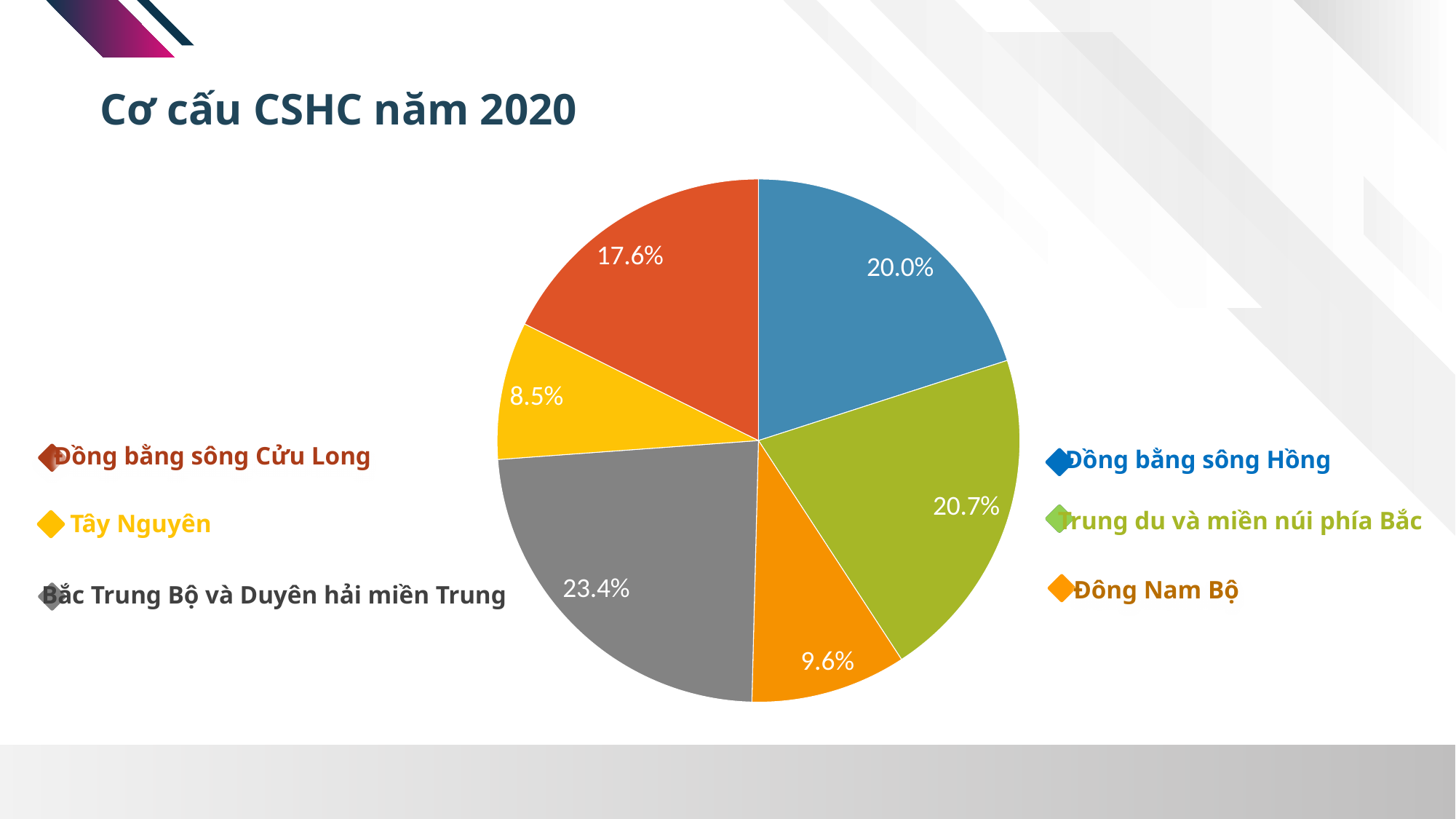
Which region has the largest share in the pie chart? Bắc Trung Bộ và Duyên hải miền Trung How many slices does the pie chart have? 6 What share does Đồng bằng sông Cửu Long have in the pie chart? 17.6% Which region has the smallest share in the pie chart? Tây Nguyên What share does Đồng bằng sông Hồng have in the pie chart? 20.0% What is the title of the chart? Cơ cấu CSHC năm 2020 What kind of chart is shown on the slide? Pie chart What is the difference between the shares of Bắc Trung Bộ và Duyên hải miền Trung and Đông Nam Bộ? 13.8% What share does Bắc Trung Bộ và Duyên hải miền Trung have in the pie chart? 23.4% What share does Trung du và miền núi phía Bắc have in the pie chart? 20.7% What share does Đông Nam Bộ have in the pie chart? 9.6% What share does Tây Nguyên have in the pie chart? 8.5%